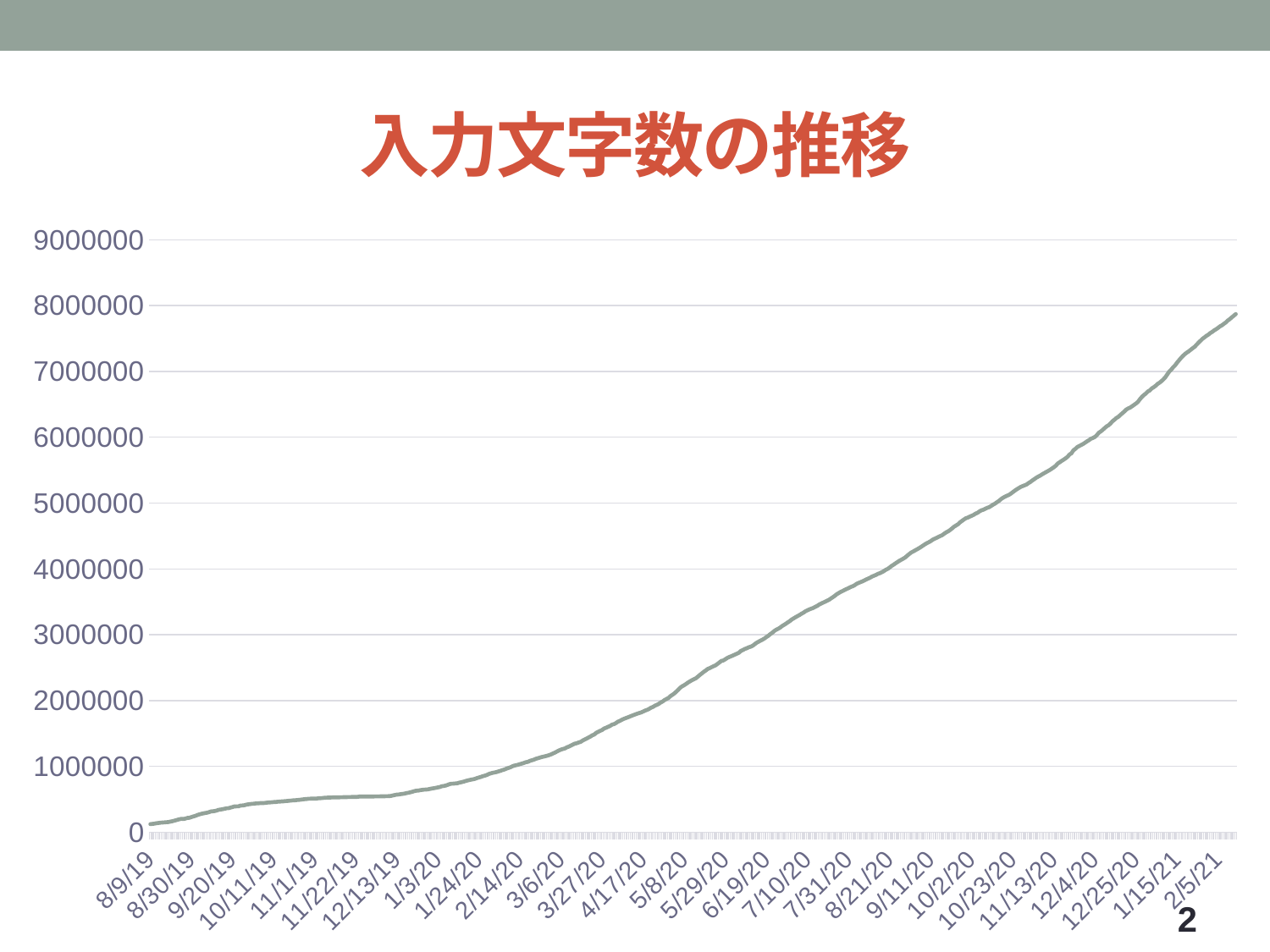
Is the value at 12/25/20 greater or less than 6000000? greater Is the value at 8/9/19 greater or less than 1000000? less What is the title of the chart? 入力文字数の推移 What is the highest value shown on the y axis? 9000000 Is the value at 1/3/20 greater or less than 1000000? less Do the values rise or fall along the x axis from 8/9/19 to 2/5/21? rise At which date on the x axis is the line at its lowest value? 8/9/19 Which is larger, the value at 2/5/21 or the value at 8/30/19? 2/5/21 What kind of chart is shown on the slide? line chart